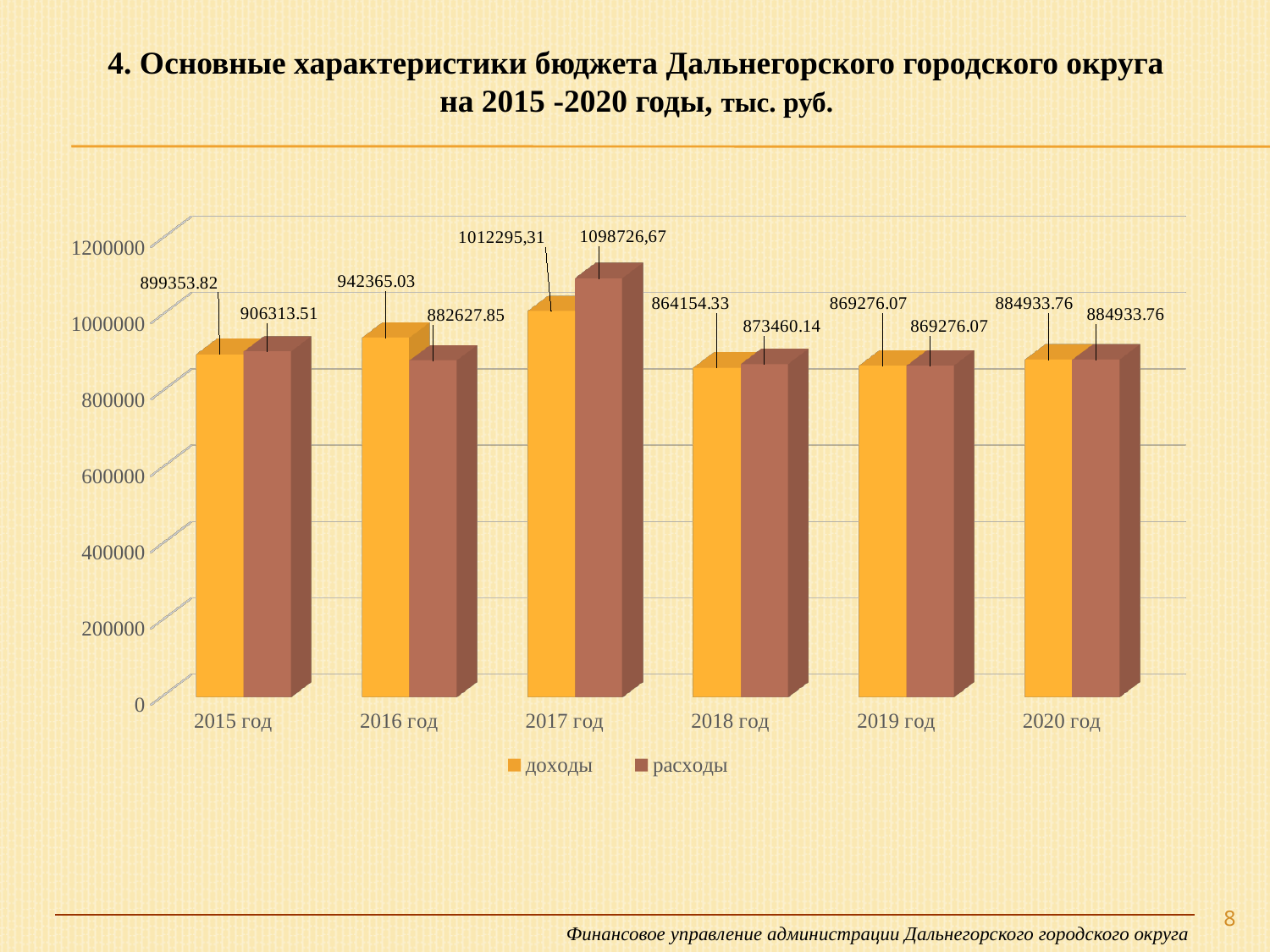
Which year has the highest value of доходы? 2017 год How many series does the legend list? 2 How many years are shown on the x axis? 6 Is the value of расходы for 2017 год greater or less than 1000000? greater Which year has the lowest value of расходы? 2019 год What is the value of доходы for 2016 год? 942365.03 Which year has the lowest value of доходы? 2018 год What is the value of расходы for 2017 год? 1098726,67 What kind of chart is shown on the slide? bar chart In 2015 год, which is larger: доходы or расходы? расходы What is the difference between доходы and расходы in 2016 год? 59737.18 What is the value of расходы for 2018 год? 873460.14